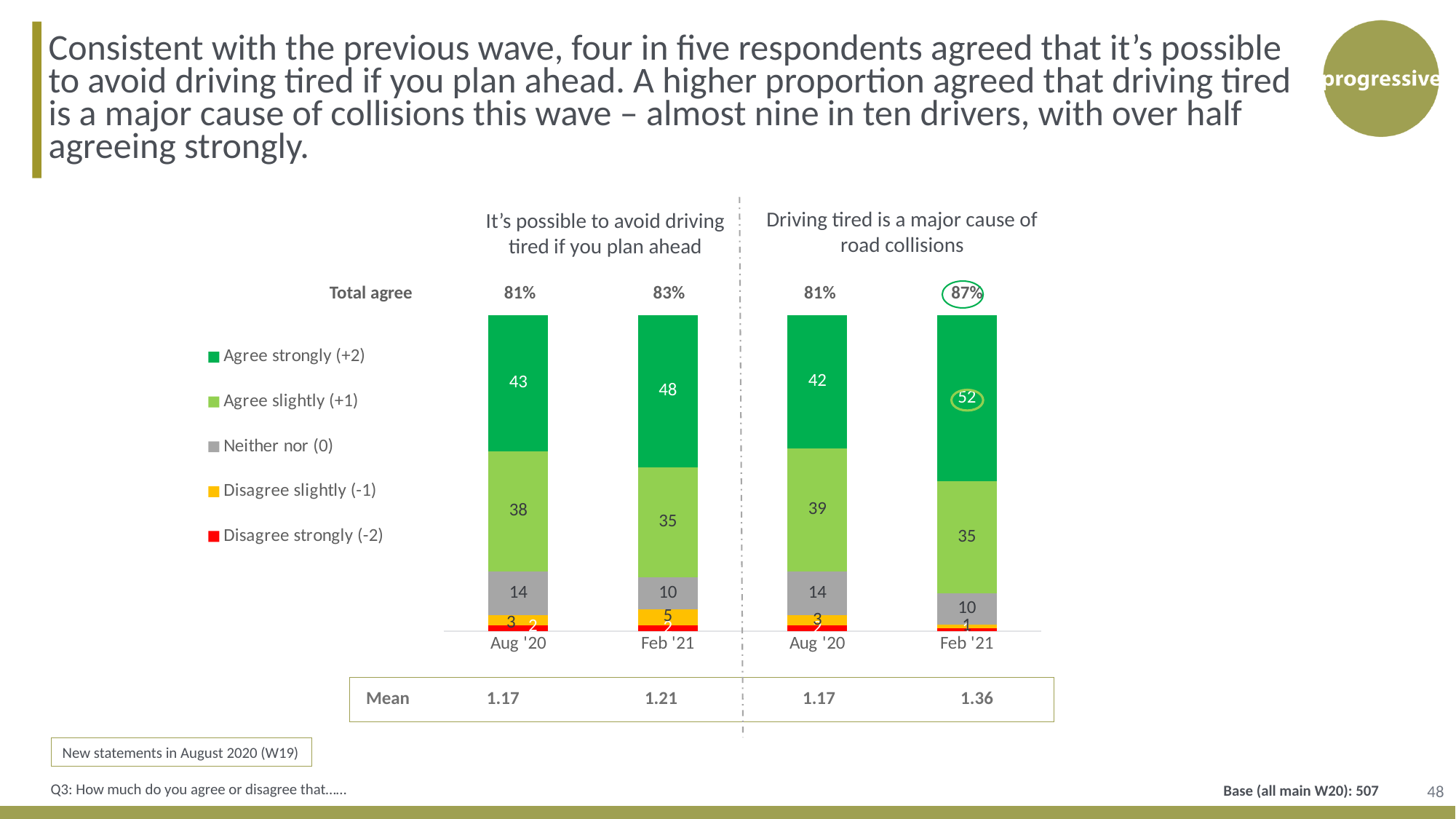
How many series does the legend list? 5 What is the 'Agree slightly (+1)' value for Aug '20 under 'It's possible to avoid driving tired if you plan ahead'? 38 What is the 'Agree strongly (+2)' value for Feb '21 under 'Driving tired is a major cause of road collisions'? 52 What is the Mean for Feb '21 under 'It's possible to avoid driving tired if you plan ahead'? 1.21 Which is larger: the 'Disagree slightly (-1)' value for Feb '21 under 'It's possible to avoid driving tired if you plan ahead' or for Feb '21 under 'Driving tired is a major cause of road collisions'? Feb '21, It's possible to avoid driving tired if you plan ahead What is the difference between the 'Agree strongly (+2)' values for Aug '20 and Feb '21 under 'It's possible to avoid driving tired if you plan ahead'? 5 Which bar has the highest 'Agree strongly (+2)' value? Feb '21, Driving tired is a major cause of road collisions What type of chart is shown on the slide? Stacked bar chart What is the Total agree figure for Feb '21 under 'Driving tired is a major cause of road collisions'? 87% How many bars are plotted in the chart? 4 What is the 'Neither nor (0)' value for Feb '21 under 'It's possible to avoid driving tired if you plan ahead'? 10 Does the Total agree for 'Driving tired is a major cause of road collisions' rise or fall from Aug '20 to Feb '21? Rise